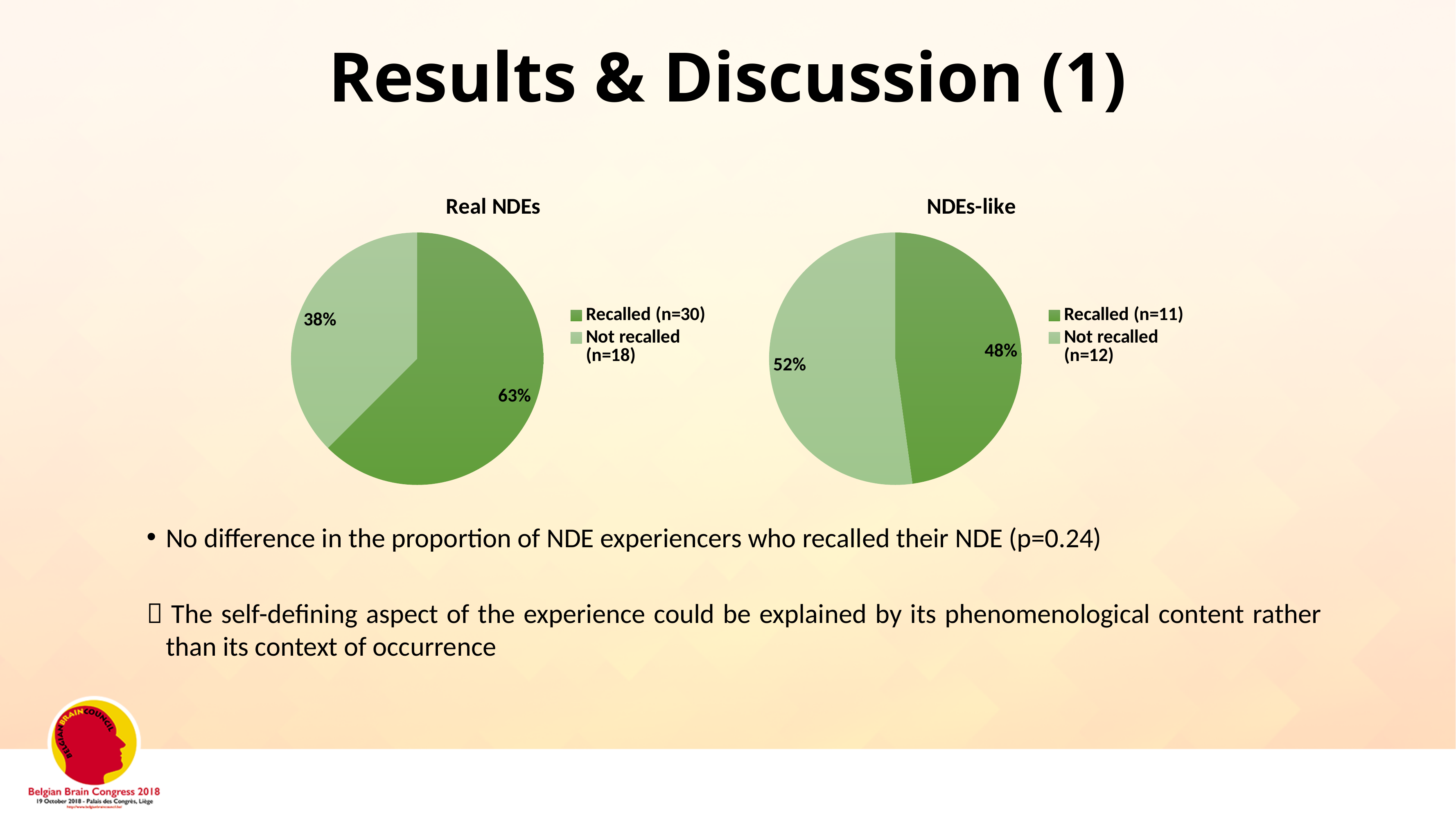
In the "Real NDEs" chart, what is the difference in percentage points between the Recalled and Not recalled slices? 25 How many slices does the "NDEs-like" chart have? 2 In the "Real NDEs" chart, how many participants does the legend give for the Not recalled category? n=18 In the "NDEs-like" chart, what percentage is shown for the Not recalled slice? 52% In the "NDEs-like" chart, which slice is the smallest? Recalled (n=11) In the "NDEs-like" chart, what percentage is shown for the Recalled slice? 48% In the "Real NDEs" chart, what percentage is shown for the Not recalled slice? 38% What type of chart is the "Real NDEs" chart? Pie chart In the "Real NDEs" chart, what percentage is shown for the Recalled slice? 63% In the "Real NDEs" chart, which slice is the largest? Recalled (n=30) In the "NDEs-like" chart, what is the difference in percentage points between the Not recalled and Recalled slices? 4 Which is larger: the Recalled share in the "Real NDEs" chart or the Recalled share in the "NDEs-like" chart? Real NDEs